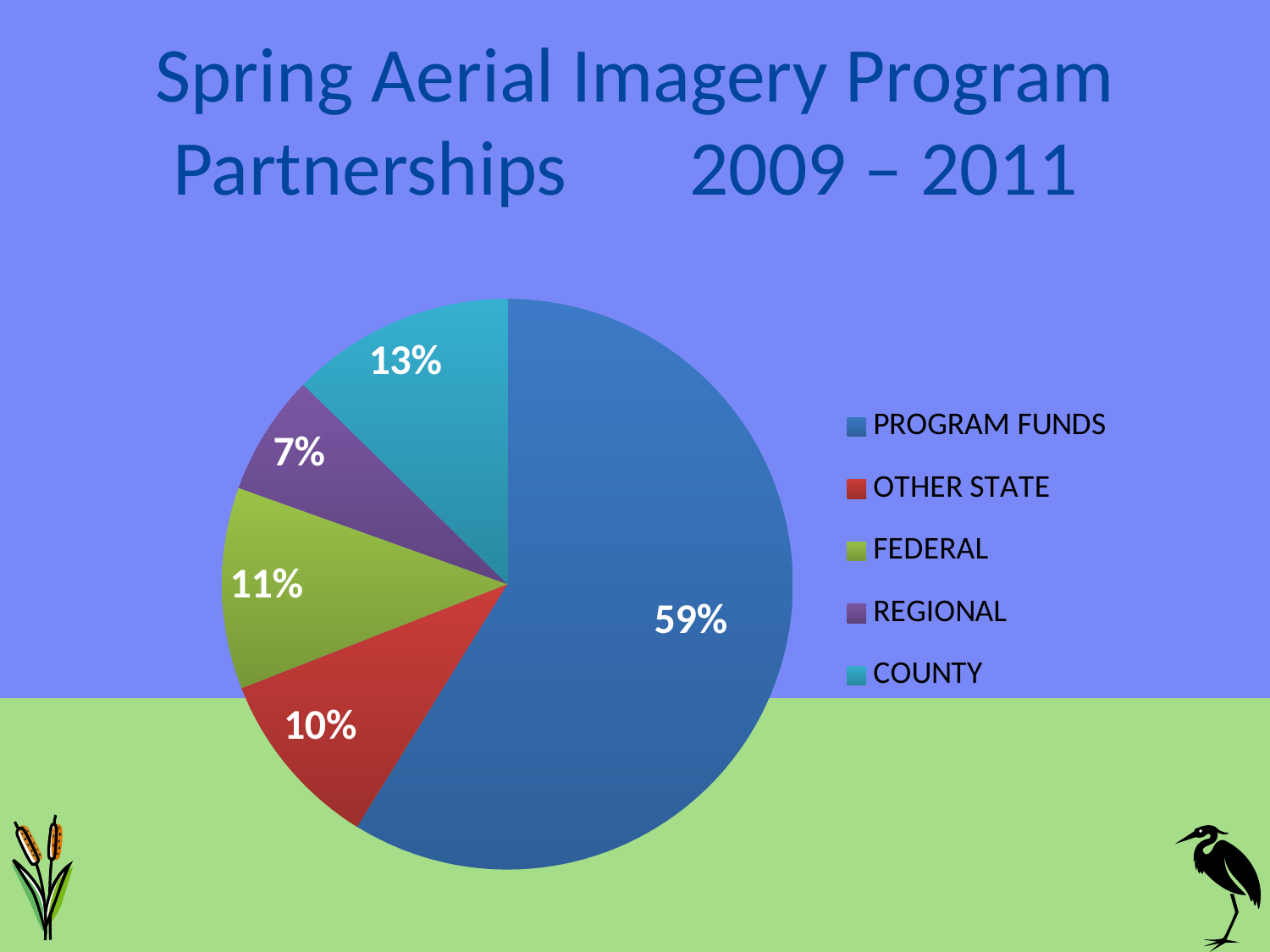
What colour is the slice for COUNTY? teal Which category has the smallest share of the pie? REGIONAL What is the value shown for COUNTY? 13% What share of the pie does PROGRAM FUNDS represent? 59% What kind of chart is shown on the slide? pie chart What is the value shown for OTHER STATE? 10% What is the difference between the PROGRAM FUNDS share and the COUNTY share? 46% Which category has the largest share of the pie? PROGRAM FUNDS What is the value shown for FEDERAL? 11% Which is larger, the FEDERAL share or the OTHER STATE share? FEDERAL How many categories does the legend list? 5 What is the value shown for REGIONAL? 7%